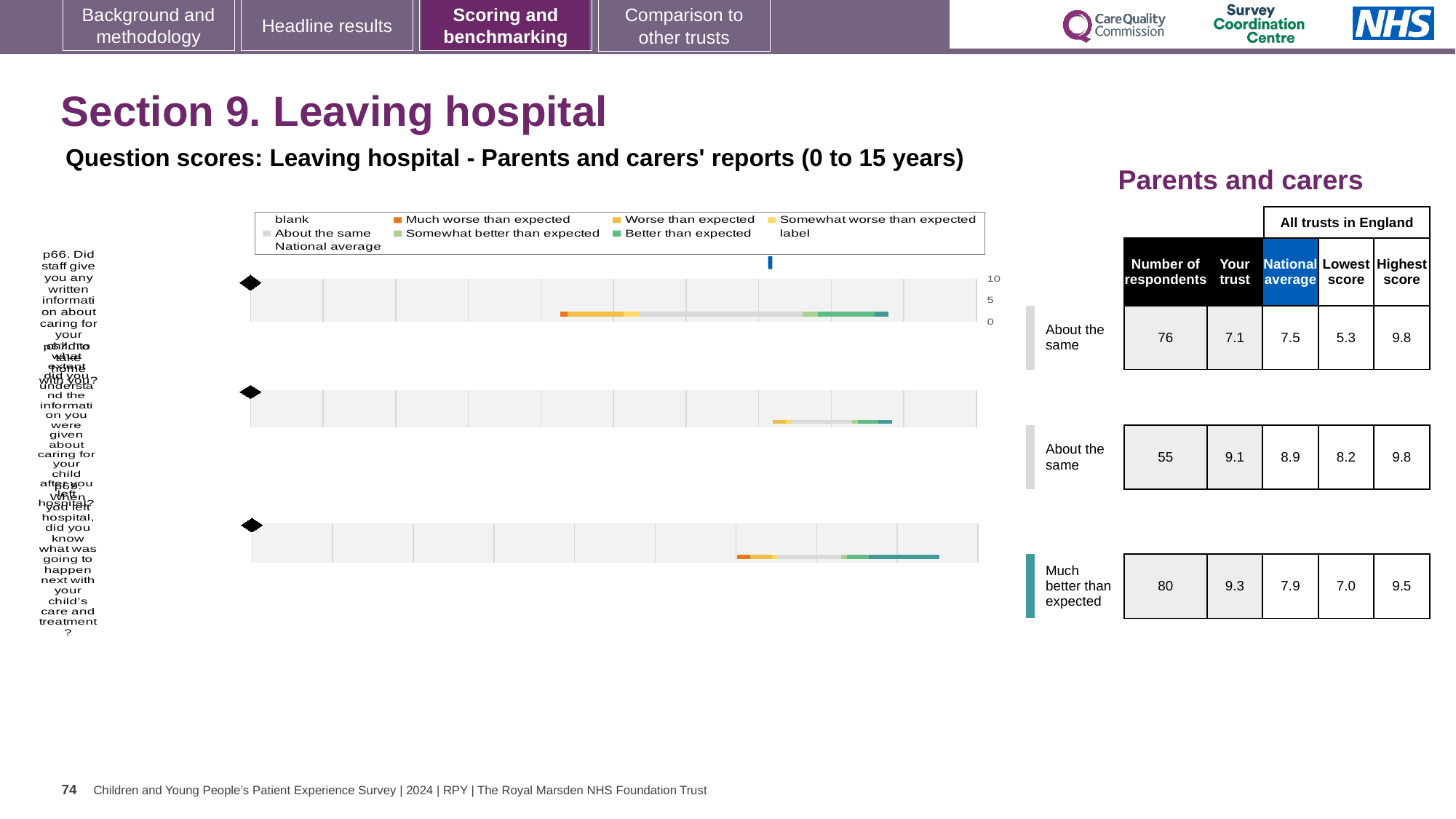
Which of the three question rows has the highest 'Your trust' score? p68 (9.3) For the second question row, what is the lowest score across all trusts in England? 8.2 How many question rows (charts) are plotted on the slide? 3 How many respondents are listed for the second question row? 55 What benchmark category is given for the third question row (p68)? Much better than expected For the third chart (p68, what was going to happen next with your child's care and treatment), what is the 'Your trust' score shown in the table? 9.3 What colour does the legend use for 'Much worse than expected'? orange For the third chart (p68), what is the difference between the highest score and the lowest score across all trusts in England? 2.5 For the first chart (p66), which is larger: the 'Your trust' score or the national average? National average What is the maximum value shown on the score axis of the charts? 10 What kind of chart is used to show the question scores on this slide? bar chart For the first chart (p66, written information about caring for your child at home), what is the national average score shown in the table? 7.5